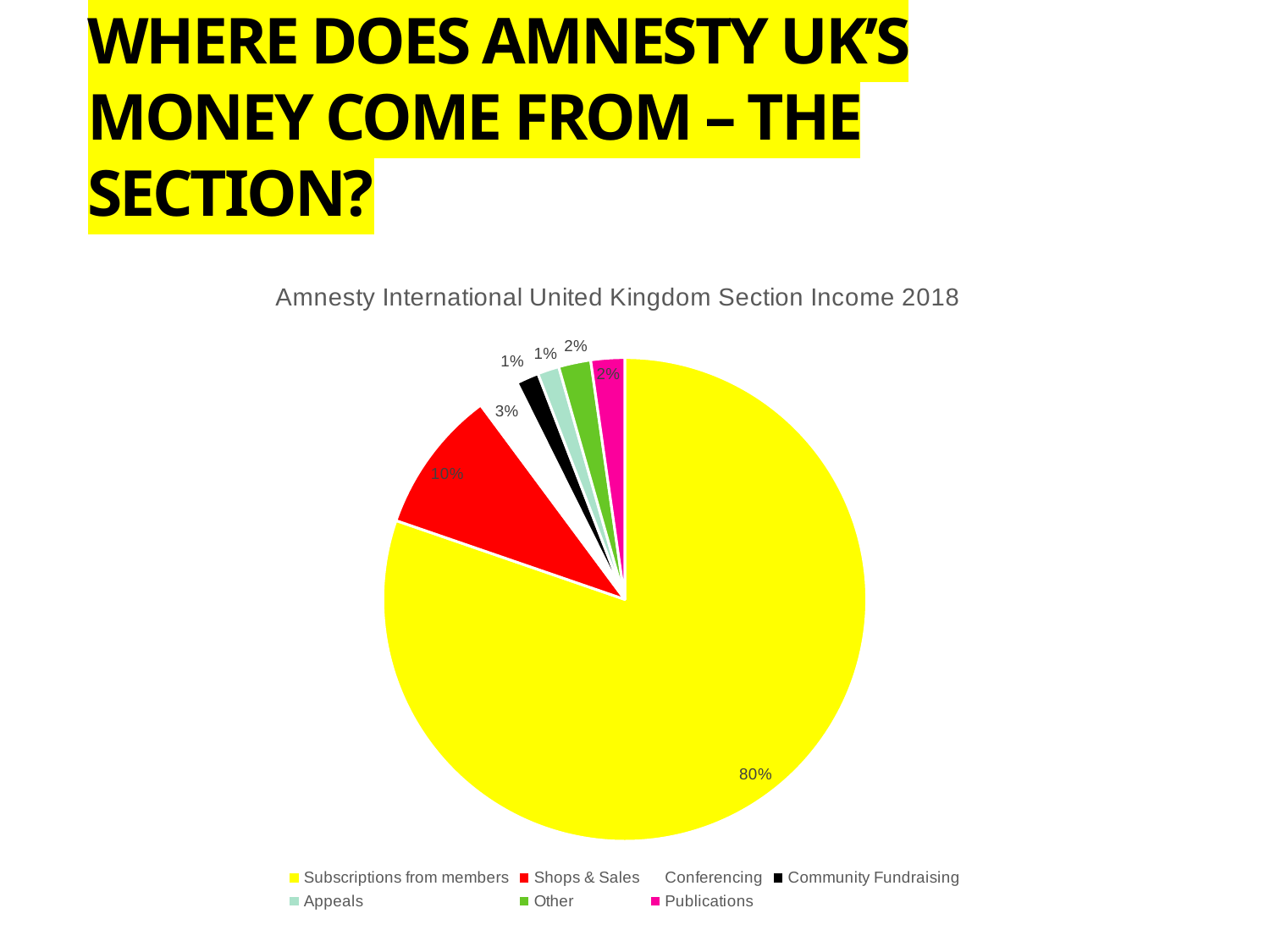
Which income source has the largest share of the pie? Subscriptions from members What share of income comes from Conferencing? 3% Which is larger, the share for Shops & Sales or the share for Conferencing? Shops & Sales What share of income comes from Subscriptions from members? 80% What is the title of the chart? Amnesty International United Kingdom Section Income 2018 What colour is the slice for Shops & Sales? red What share of income comes from Publications? 2% How many income categories does the legend list? 7 What is the difference in percentage points between Subscriptions from members and Shops & Sales? 70 What type of chart is shown on the slide? pie chart